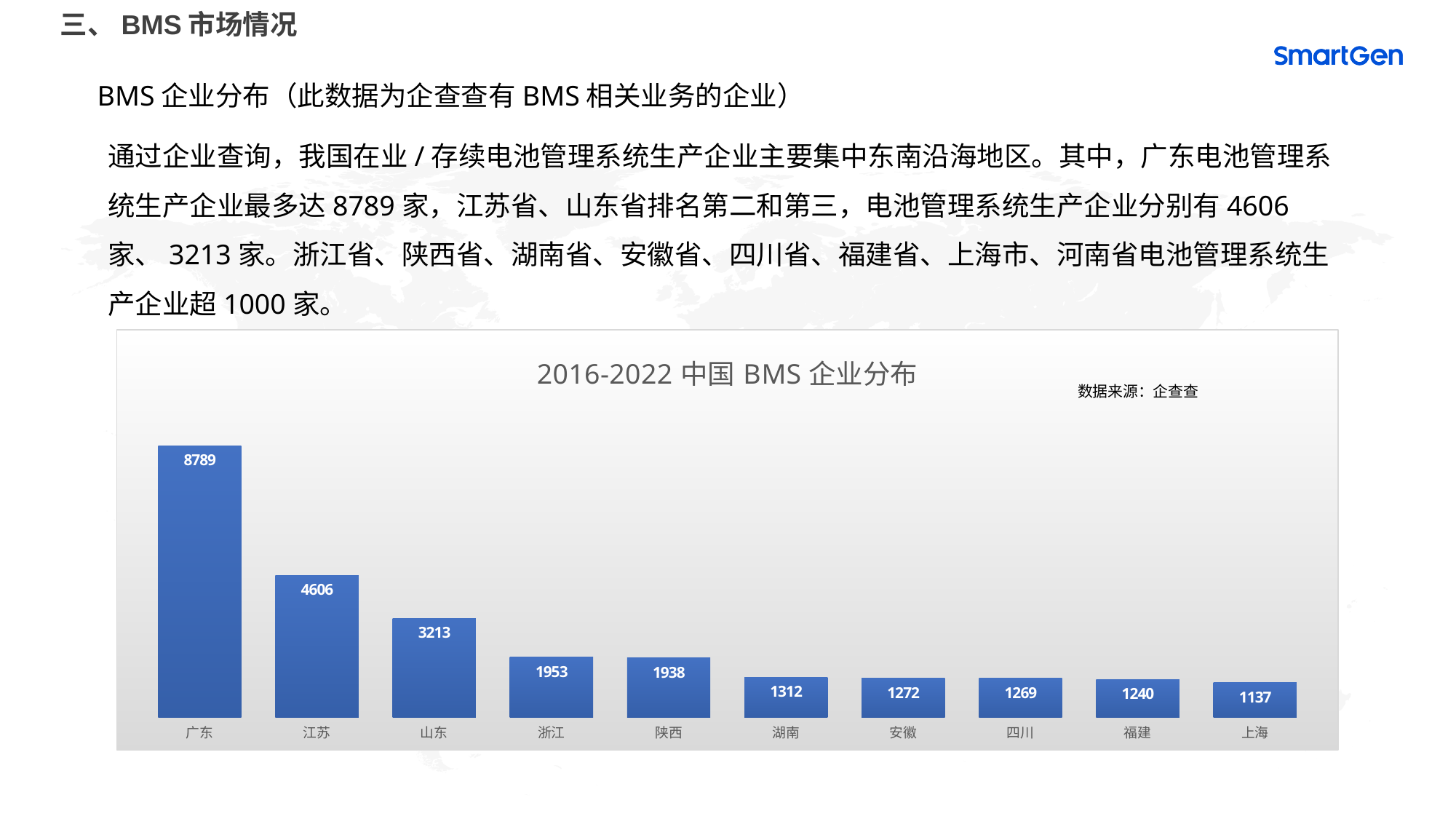
Which is larger, the value for 湖南 or the value for 上海? 湖南 What is the difference between the values for 广东 and 江苏? 4183 What is the value for 山东? 3213 What is the difference between the values for 浙江 and 陕西? 15 What kind of chart is shown on the slide? bar chart What is the value for 广东? 8789 How many categories are shown in the chart? 10 Which is larger, the value for 江苏 or the value for 山东? 江苏 Which category has the lowest value? 上海 What is the value for 福建? 1240 What is the title of the chart? 2016-2022 中国 BMS 企业分布 Which category has the highest value? 广东